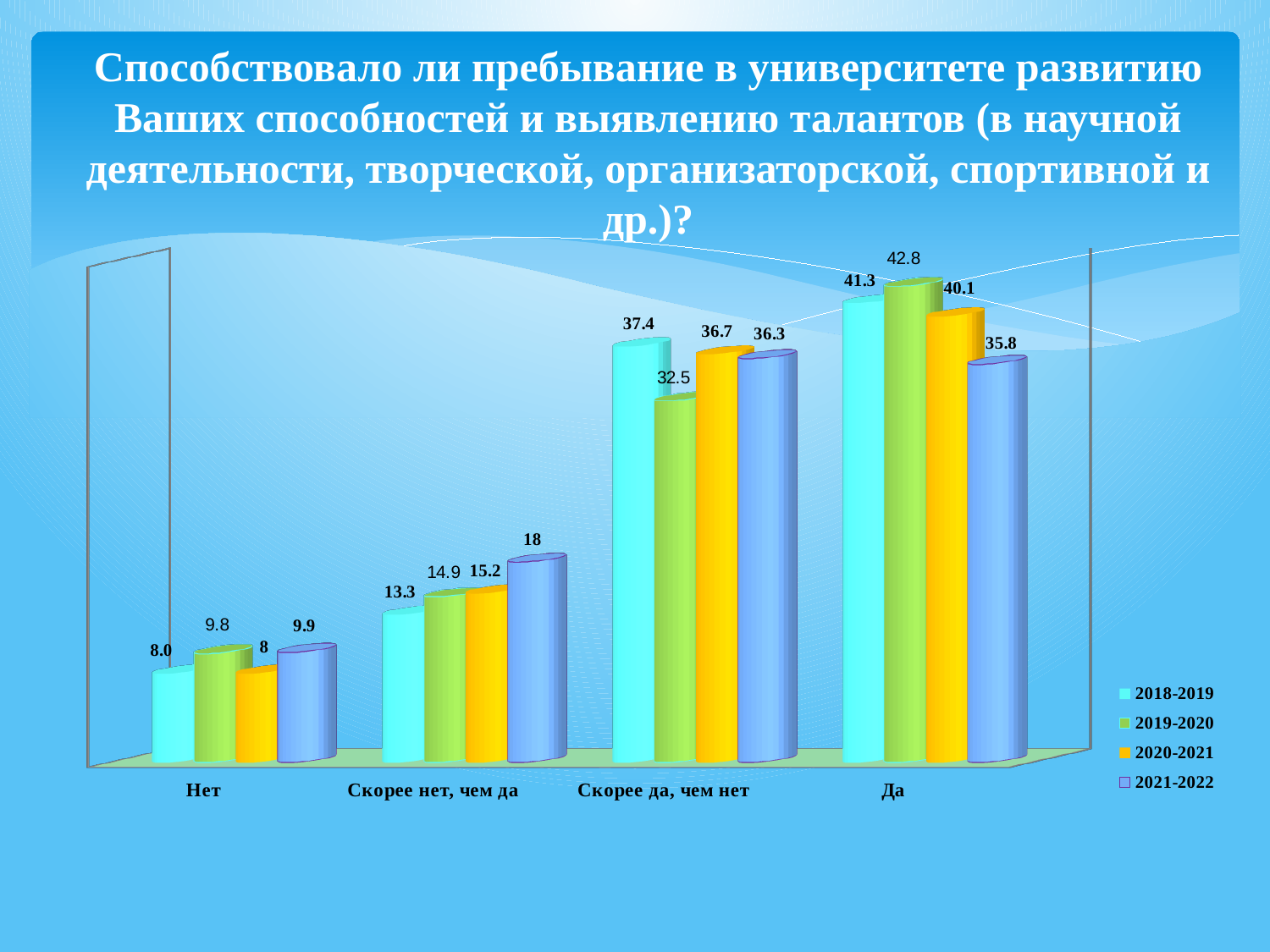
How many series does the legend list? 4 What is the value for "Скорее нет, чем да" in the 2021-2022 series? 18 What is the difference between the 2019-2020 and 2021-2022 values for "Да"? 7 Which category has the highest value in the 2021-2022 series? Скорее да, чем нет What kind of chart is shown on the slide? Bar chart What is the value for "Нет" in the 2020-2021 series? 8 How many categories are shown on the x axis? 4 What is the value for "Да" in the 2019-2020 series? 42.8 Which is larger for "Скорее нет, чем да": the 2018-2019 value or the 2021-2022 value? 2021-2022 What is the difference between the 2018-2019 and 2019-2020 values for "Скорее да, чем нет"? 4.9 Which category has the lowest value in the 2018-2019 series? Нет What is the value for "Скорее да, чем нет" in the 2018-2019 series? 37.4